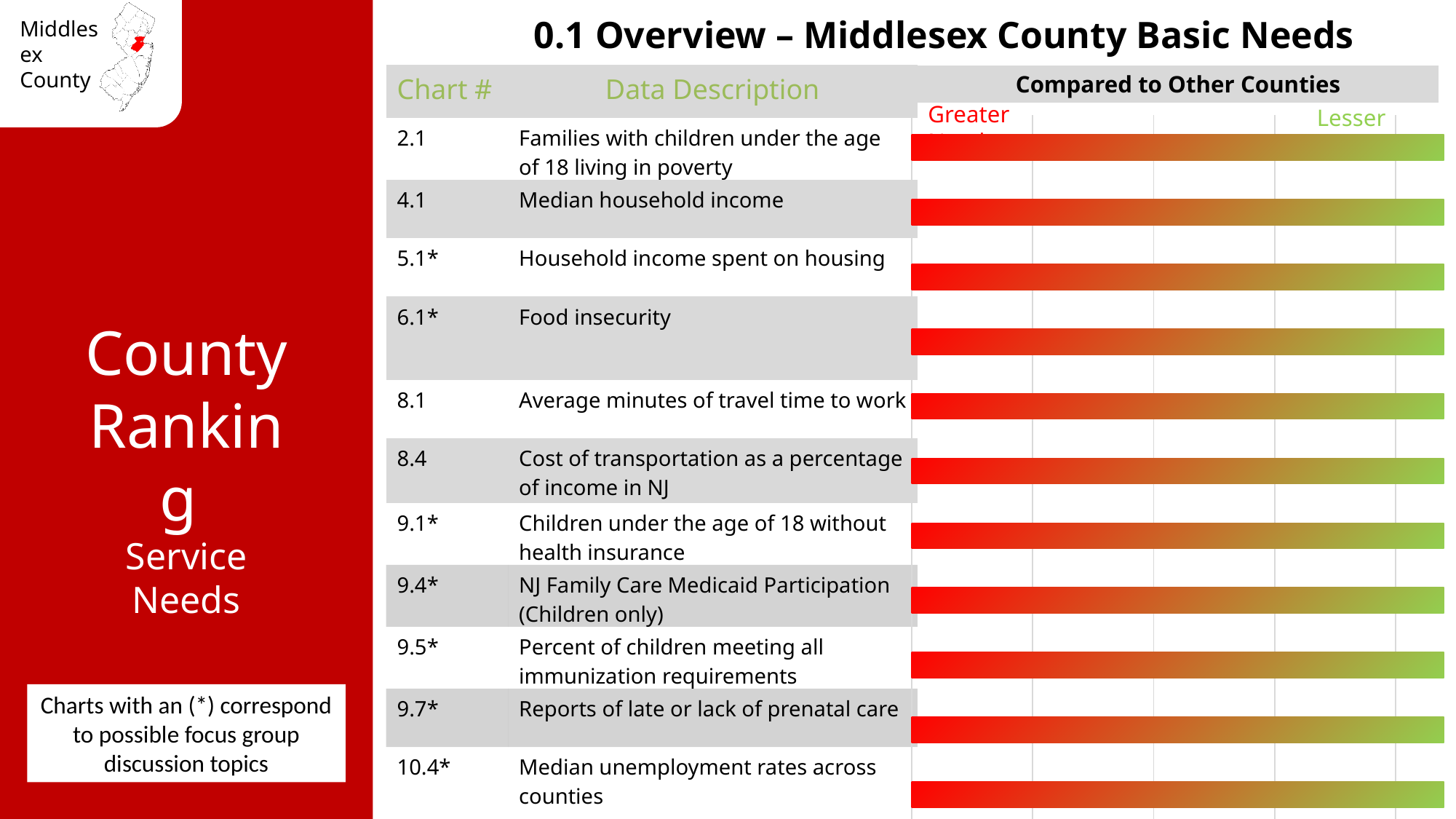
Which chart number corresponds to 'Median household income'? 4.1 Which chart number corresponds to the data description 'Food insecurity'? 6.1* How many data description rows (bars) are shown in the 'Compared to Other Counties' chart? 11 What kind of chart is shown on the right side of the slide under 'Compared to Other Counties'? bar chart How many of the listed chart numbers are marked with an asterisk (*)? 7 What is the title of the slide containing the 'Compared to Other Counties' chart? 0.1 Overview – Middlesex County Basic Needs Which chart number corresponds to 'Average minutes of travel time to work'? 8.1 In the 'Compared to Other Counties' chart, which end of the scale is labelled 'Lesser', the left or the right? right What data description is listed for chart number 10.4*? Median unemployment rates across counties